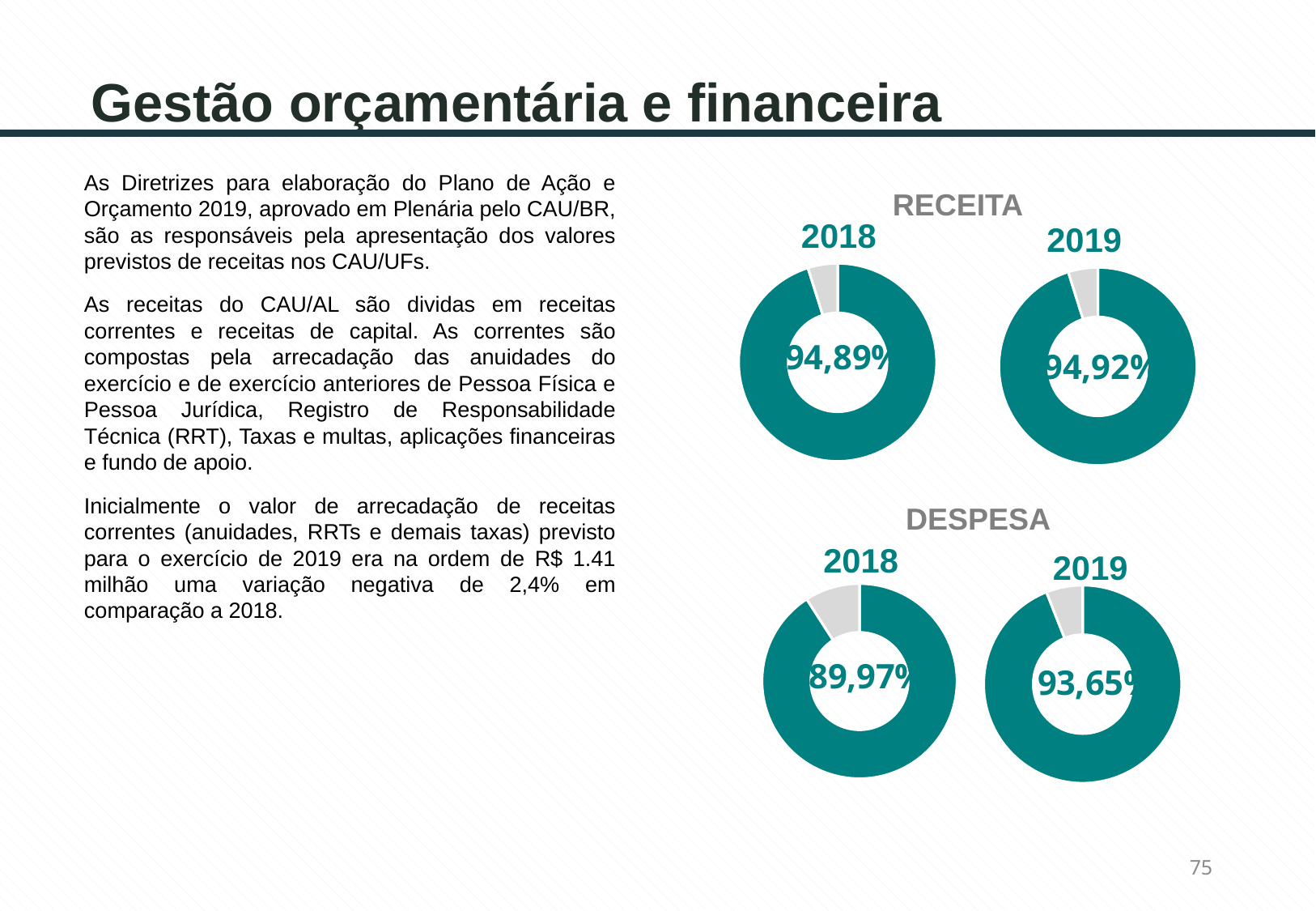
In the DESPESA 2018 donut chart, what percentage is shown in the centre? 89,97% What kind of chart is used to show the RECEITA and DESPESA values? Donut (pie) chart What is the difference in percentage points between the DESPESA 2019 value and the DESPESA 2018 value? 3,68 What is the difference in percentage points between the RECEITA 2019 value and the RECEITA 2018 value? 0,03 What are the titles of the two groups of donut charts on the slide? RECEITA and DESPESA Comparing the DESPESA charts, which year shows the larger percentage, 2018 or 2019? 2019 Among the four donut charts on the slide, which one shows the lowest percentage? DESPESA 2018 Is the DESPESA 2018 value greater or less than 90%? less How many donut charts are shown on the slide? 4 In the RECEITA 2019 donut chart, what percentage is shown in the centre? 94,92% In the RECEITA 2018 donut chart, what percentage is shown in the centre? 94,89% In the DESPESA 2019 donut chart, what percentage is shown in the centre? 93,65%